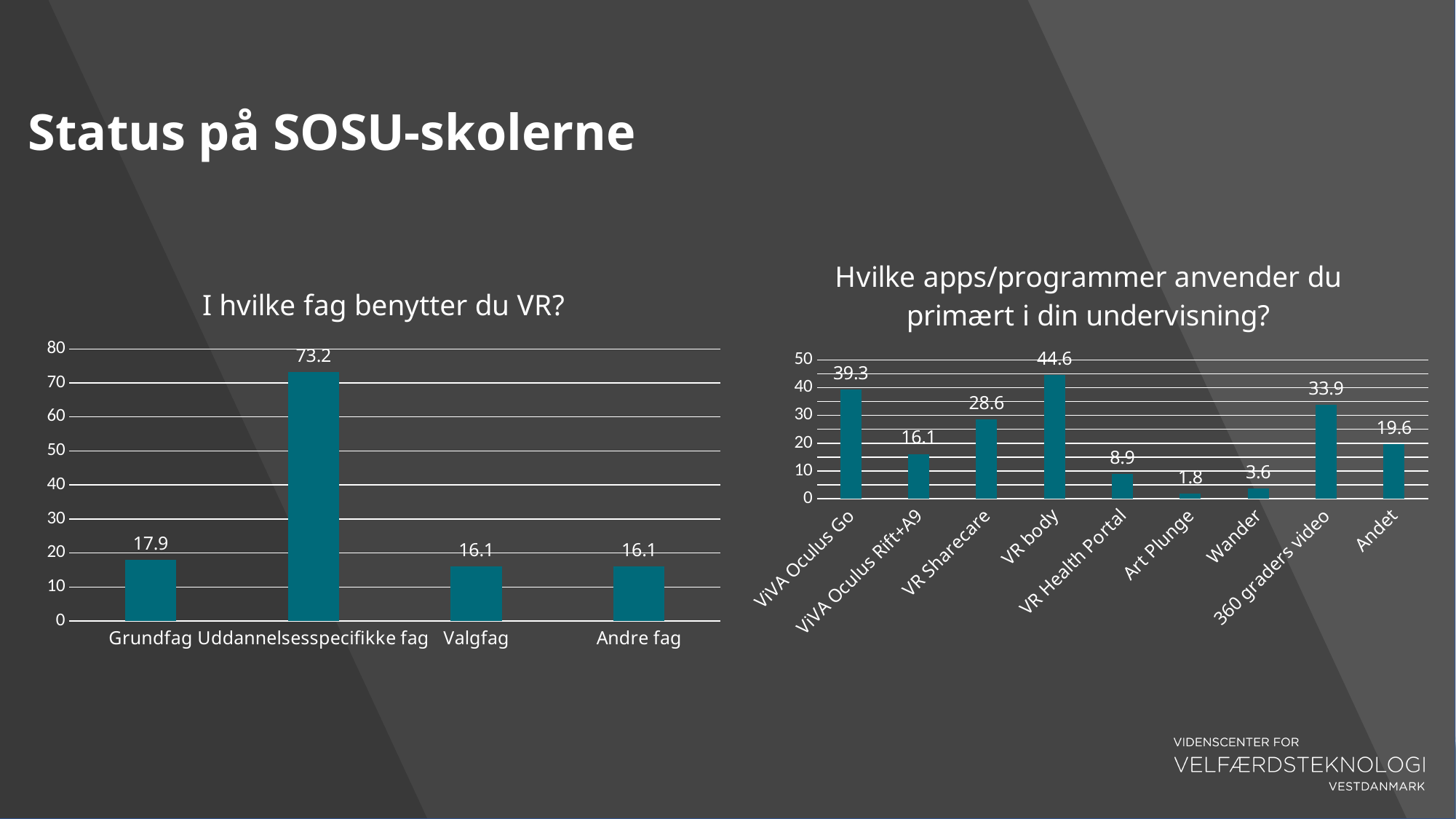
In the chart 'Hvilke apps/programmer anvender du primært i din undervisning?', which is larger: ViVA Oculus Go or VR Sharecare? ViVA Oculus Go In the chart 'I hvilke fag benytter du VR?', how many categories are shown? 4 In the chart 'Hvilke apps/programmer anvender du primært i din undervisning?', what is the difference between VR body and ViVA Oculus Go? 5.3 In the chart 'Hvilke apps/programmer anvender du primært i din undervisning?', which category has the lowest value? Art Plunge In the chart 'Hvilke apps/programmer anvender du primært i din undervisning?', what is the value for 360 graders video? 33.9 In the chart 'I hvilke fag benytter du VR?', what is the value for Grundfag? 17.9 In the chart 'Hvilke apps/programmer anvender du primært i din undervisning?', what is the value for VR body? 44.6 What kind of chart is the chart 'I hvilke fag benytter du VR?'? Bar chart In the chart 'Hvilke apps/programmer anvender du primært i din undervisning?', how many categories are shown? 9 In the chart 'I hvilke fag benytter du VR?', which category has the highest value? Uddannelsesspecifikke fag In the chart 'I hvilke fag benytter du VR?', what is the difference between Uddannelsesspecifikke fag and Grundfag? 55.3 In the chart 'I hvilke fag benytter du VR?', what is the value for Uddannelsesspecifikke fag? 73.2